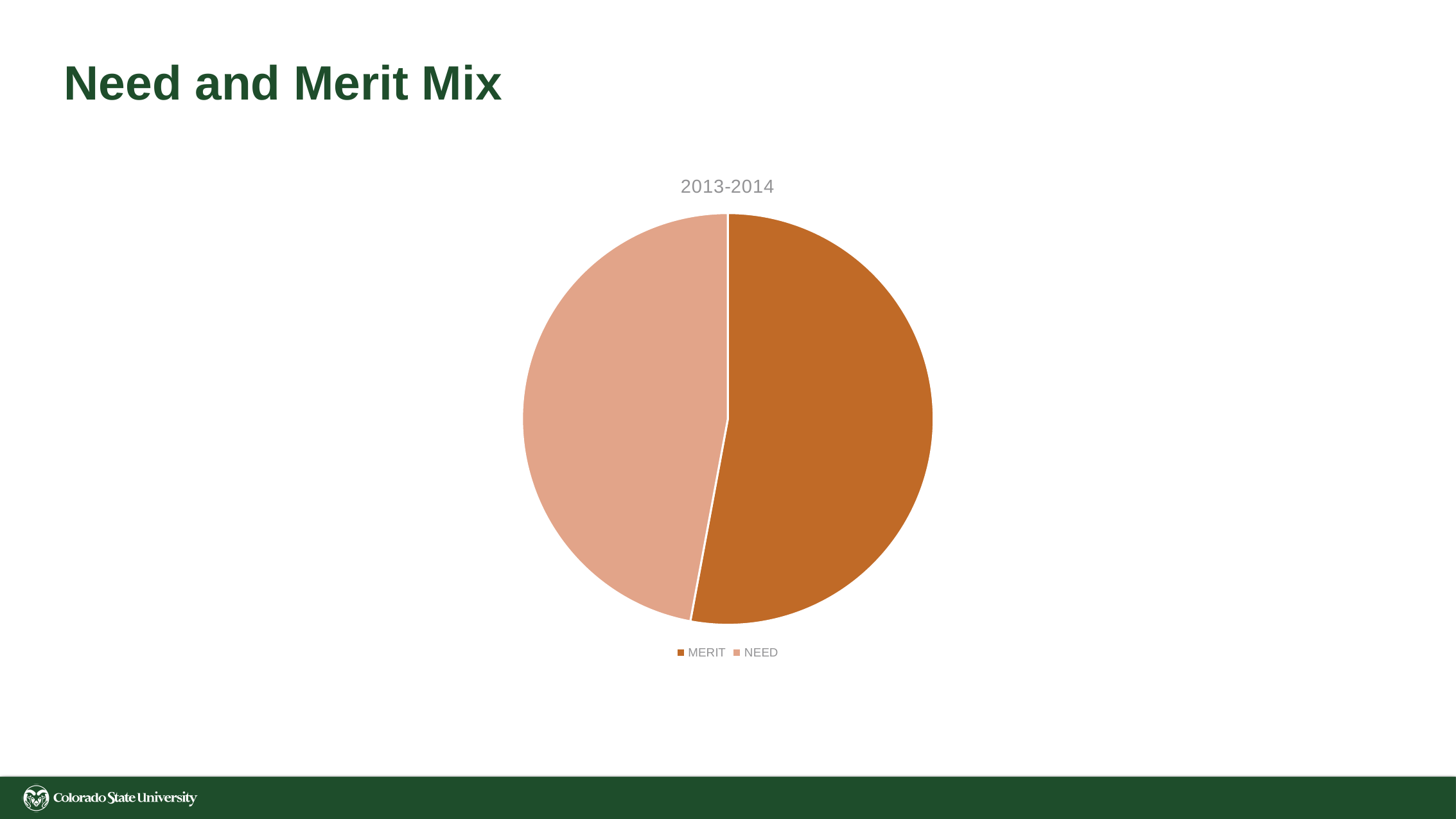
What are the two categories listed in the legend of the pie chart? MERIT and NEED What is the title of the pie chart? 2013-2014 How many slices does the pie chart have? 2 Which slice of the pie chart is larger, MERIT or NEED? MERIT How many entries does the legend of the pie chart list? 2 What kind of chart is shown on the slide? pie chart Which category has the smallest slice in the pie chart? NEED Which category has the largest slice in the pie chart? MERIT